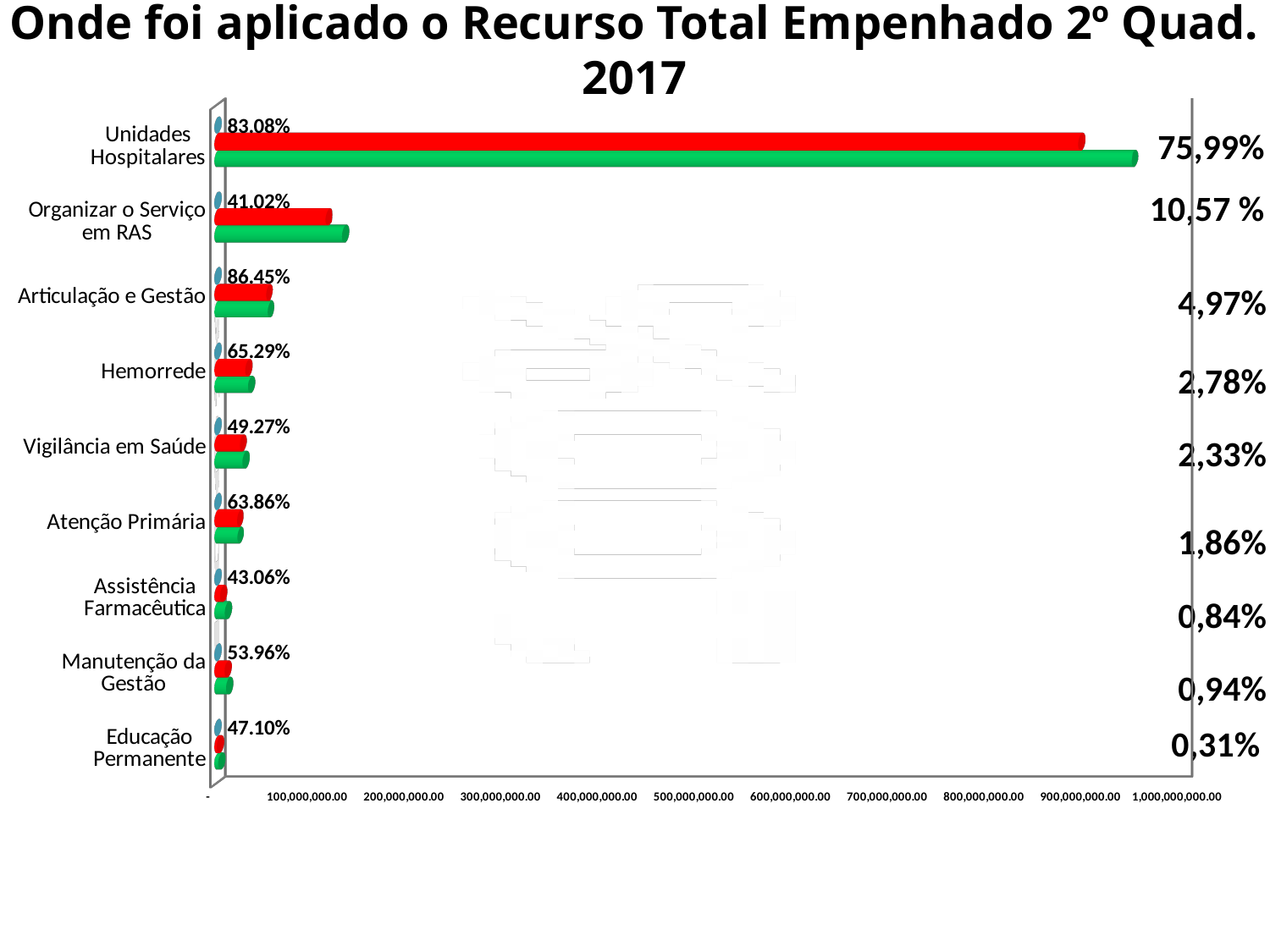
Which category has the lowest percentage label on the left side of the chart? Organizar o Serviço em RAS Which category has the highest percentage label on the left side of the chart? Articulação e Gestão What percentage label is shown next to Hemorrede on the left side of the chart? 65.29% How many categories are listed on the vertical axis of the chart? 9 Which category has the longest bars in the chart? Unidades Hospitalares What percentage label is shown next to Unidades Hospitalares on the left side of the chart? 83.08% What percentage is shown at the right edge of the chart for Unidades Hospitalares? 75,99% What percentage is shown at the right edge of the chart for Educação Permanente? 0,31% What is the difference between the left-side percentage labels for Unidades Hospitalares and Organizar o Serviço em RAS? 42.06% Is the green bar for Articulação e Gestão greater or less than 100,000,000.00? less Is the green bar for Unidades Hospitalares greater or less than 900,000,000.00? greater What kind of chart is shown on the slide? bar chart